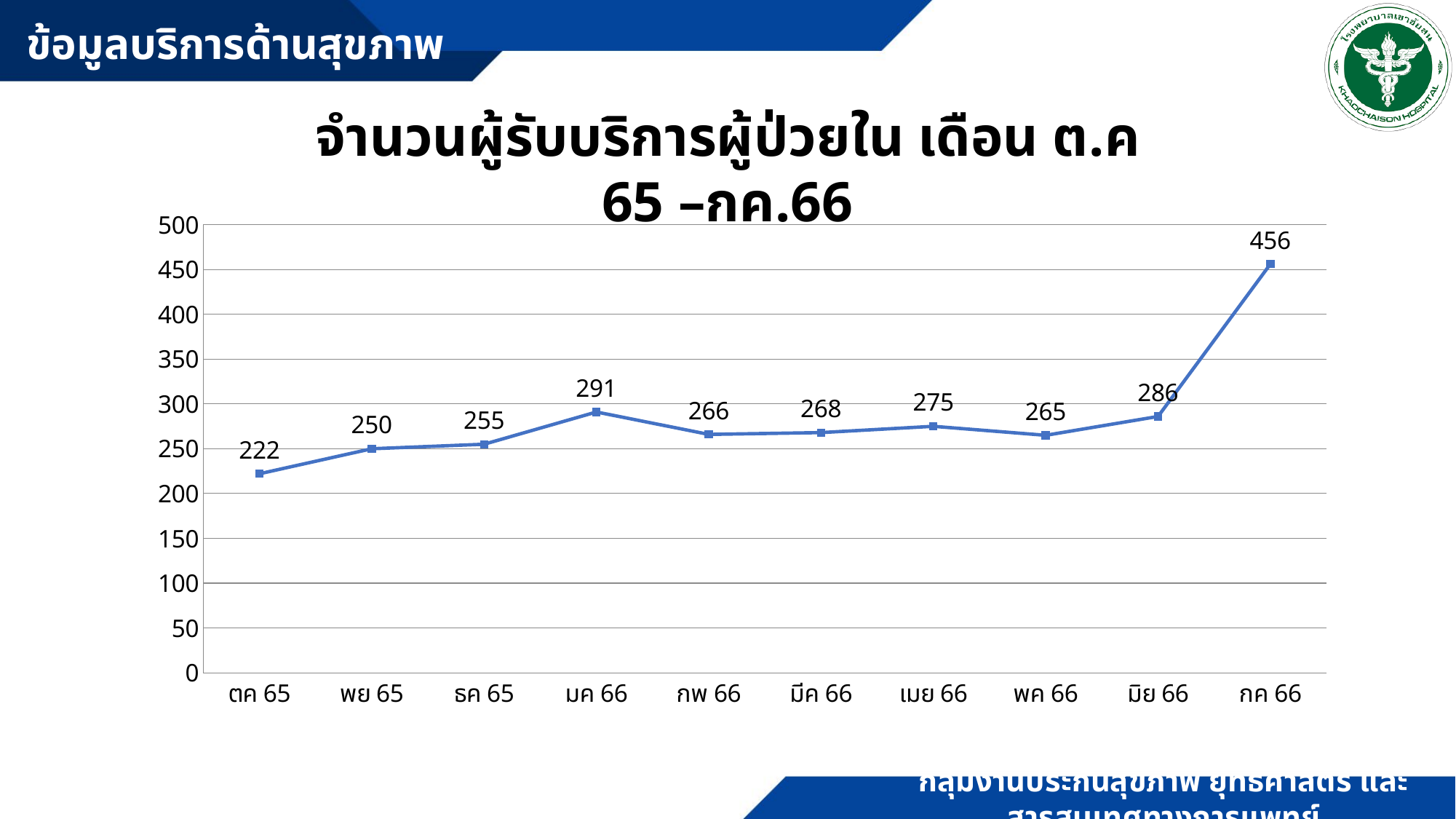
How many months are plotted on the chart? 10 What is the value for กค 66? 456 Is the value for พค 66 greater or less than 300? less What is the difference between the values for มค 66 and ตค 65? 69 Does the value rise or fall from มิย 66 to กค 66? rise What is the difference between the values for กค 66 and มิย 66? 170 What kind of chart is shown on the slide? line chart Which is larger, the value for มค 66 or the value for เมย 66? มค 66 What is the value for ตค 65? 222 What is the value for มค 66? 291 Which month has the highest value? กค 66 Which month has the lowest value? ตค 65